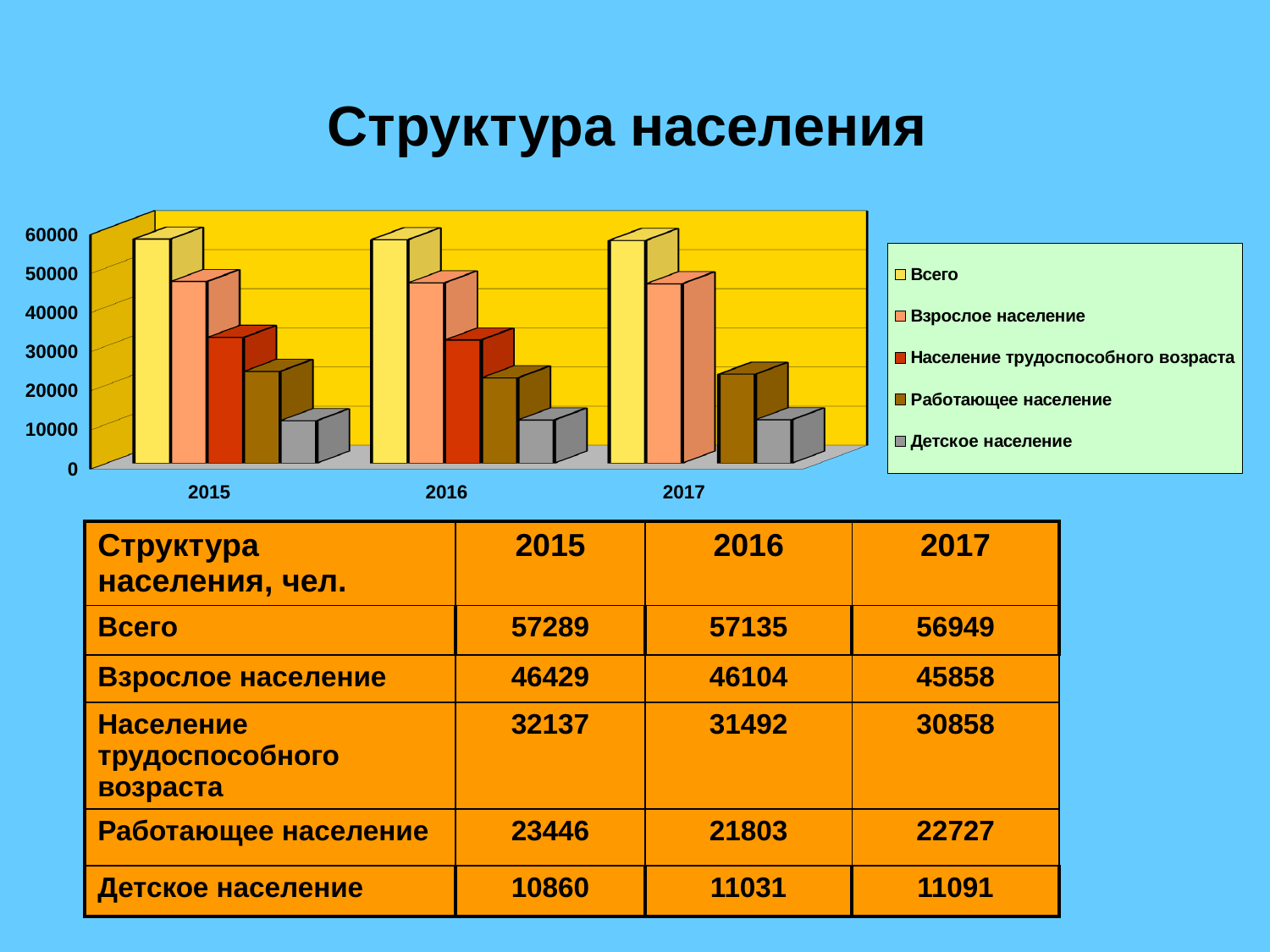
How many series does the chart legend list? 5 Which series has the lowest values in every year? Детское население What is the value for Всего in 2015? 57289 Which is larger, Работающее население in 2015 or in 2017? 2015 What is the value for Работающее население in 2016? 21803 What is the value for Детское население in 2017? 11091 Which series has the highest values in every year? Всего What kind of chart is shown on the slide? bar chart What is the difference between Всего and Взрослое население in 2016? 11031 How many year categories are shown on the x axis of the chart? 3 Is the value for Взрослое население in 2015 greater or less than 40000? greater Does the value for Всего rise or fall from 2015 to 2017? fall